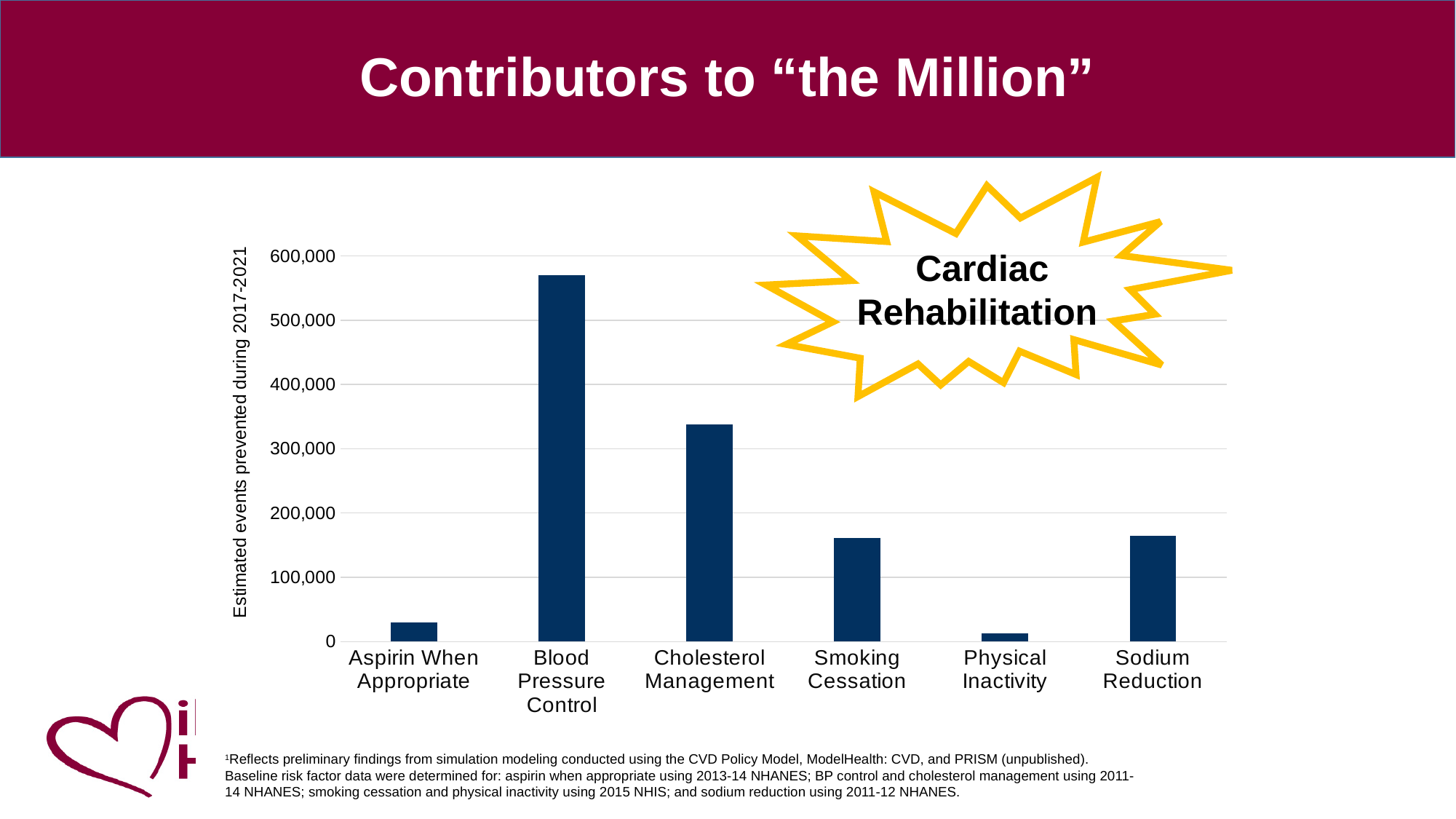
Which category has the lowest estimated events prevented during 2017-2021? Physical Inactivity Is the value for Aspirin When Appropriate greater or less than 100,000? less Which is larger, the value for Aspirin When Appropriate or the value for Physical Inactivity? Aspirin When Appropriate What kind of chart is shown on the slide? bar chart Is the value for Smoking Cessation greater or less than 200,000? less What is the label of the vertical axis of the chart? Estimated events prevented during 2017-2021 Is the value for Sodium Reduction greater or less than 100,000? greater Which category has the highest estimated events prevented during 2017-2021? Blood Pressure Control How many categories are plotted on the x axis of the chart? 6 Which is larger, the value for Cholesterol Management or the value for Smoking Cessation? Cholesterol Management